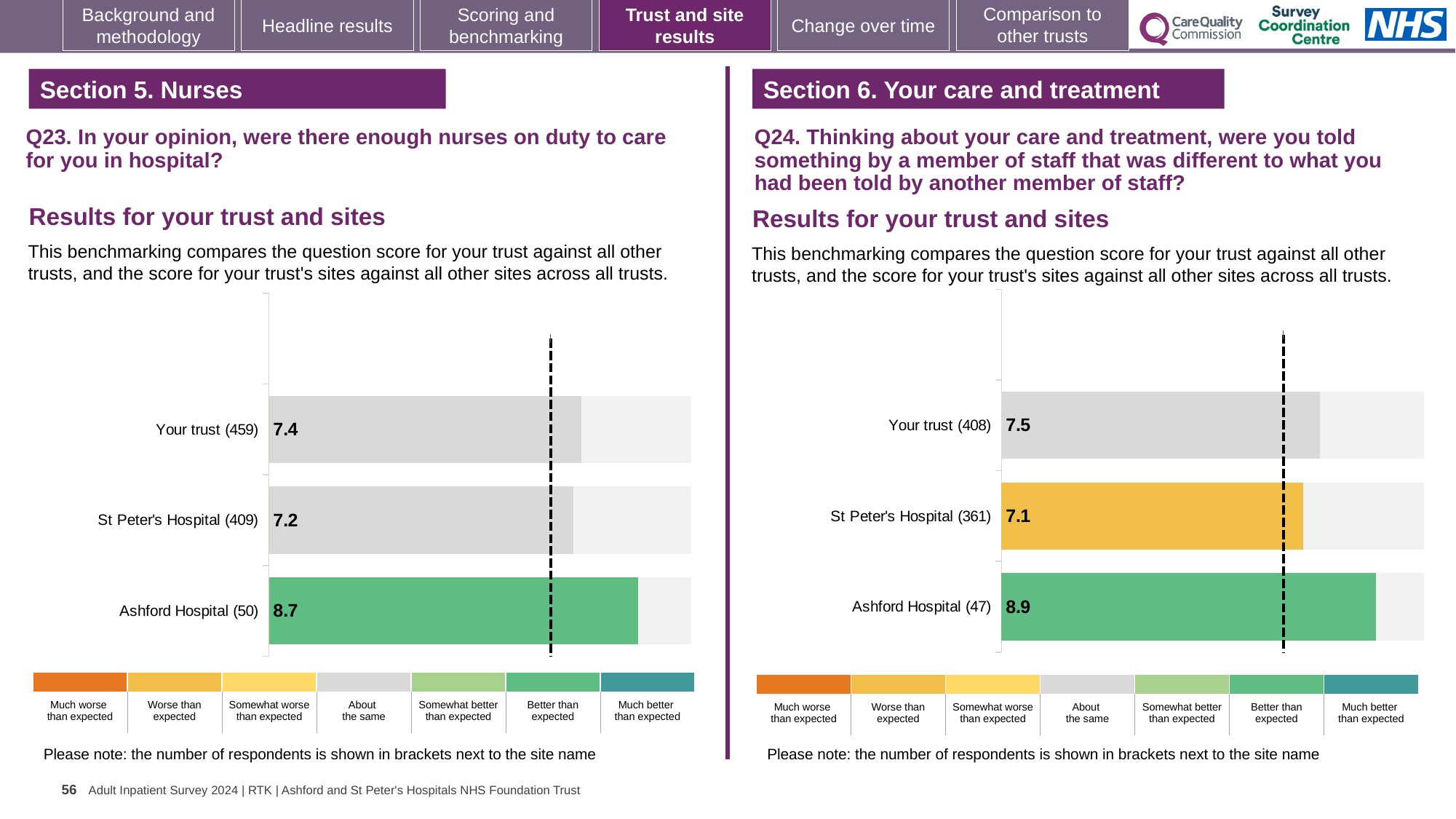
What type of chart is used for the Q24 results (right)? Bar chart On the Q23 chart (left), which site or trust has the lowest score? St Peter's Hospital (409) On the Q24 chart (right), what is the score for St Peter's Hospital (361)? 7.1 On the Q23 chart (left), what is the score for Ashford Hospital (50)? 8.7 On the Q24 chart (right), what is the difference between the scores for Your trust (408) and St Peter's Hospital (361)? 0.4 On the Q23 chart (left), what is the score for Your trust (459)? 7.4 How many bars are shown on the Q23 chart (left)? 3 On the Q24 chart (right), which has the larger score, Your trust (408) or Ashford Hospital (47)? Ashford Hospital (47) On the Q24 chart (right), which site or trust has the highest score? Ashford Hospital (47) On the Q24 chart (right), what is the score for Ashford Hospital (47)? 8.9 On the Q23 chart (left), which site or trust has the highest score? Ashford Hospital (50) On the Q23 chart (left), what is the difference between the scores for Ashford Hospital (50) and St Peter's Hospital (409)? 1.5